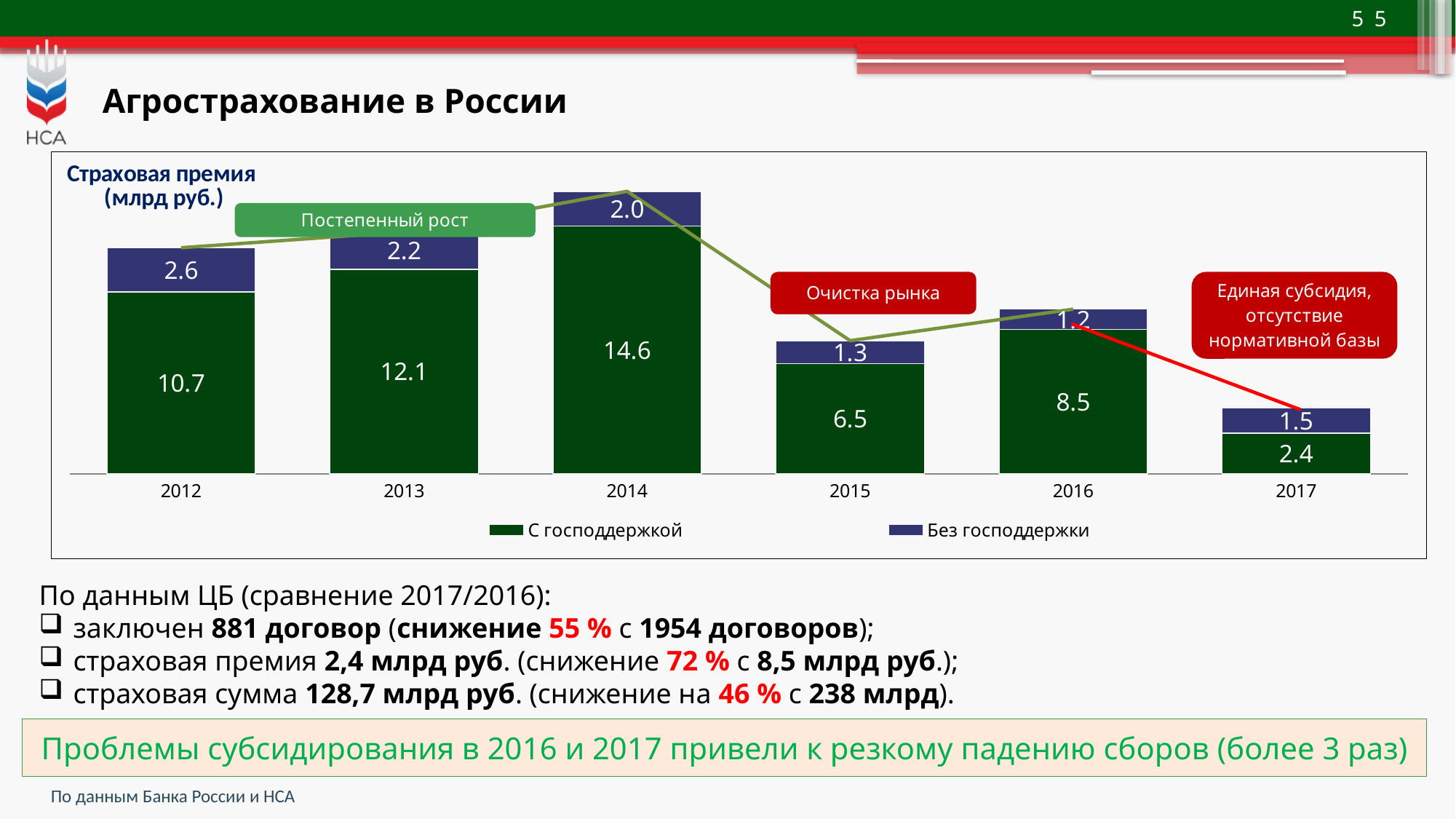
What is the difference between the 'С господдержкой' values for 2016 and 2017? 6.1 Which year has the lowest value for 'Без господдержки'? 2016 What is the value for 'С господдержкой' in 2014? 14.6 What is the total of the stacked bar for 2017? 3.9 What is the value for 'Без господдержки' in 2012? 2.6 What kind of chart is shown on the slide? Stacked bar chart with a line Which is larger: the 'С господдержкой' value for 2015 or for 2016? 2016 How many years are shown on the x axis? 6 What is the total of the stacked bar for 2014? 16.6 What is the value for 'С господдержкой' in 2017? 2.4 Which year has the highest value for 'С господдержкой'? 2014 How many series does the legend list? 2